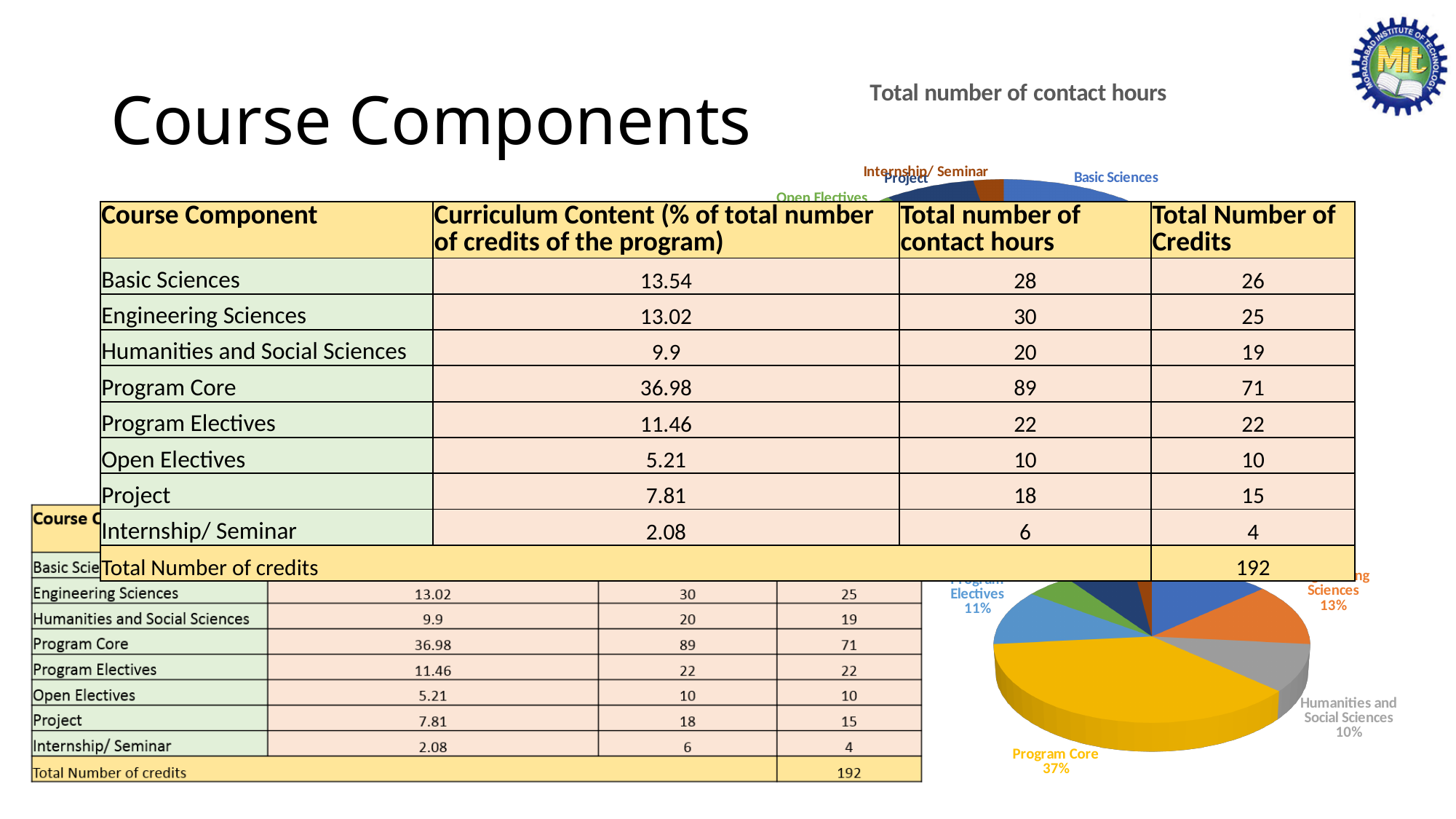
In the pie chart, what share does Program Core have? 37% In the pie chart, what share does Program Electives have? 11% In the pie chart, how many percentage points larger is the Program Core share than the Humanities and Social Sciences share? 27% Which slice of the pie chart is the largest? Program Core In the pie chart, how many percentage points larger is the Program Core share than the Program Electives share? 26% In the pie chart, what share does Humanities and Social Sciences have? 10% What is the title of the pie chart? Total number of contact hours What colour is the Program Core slice in the pie chart? yellow In the pie chart, which is larger: the Program Core slice or the Humanities and Social Sciences slice? Program Core What kind of chart is shown on the slide? pie chart